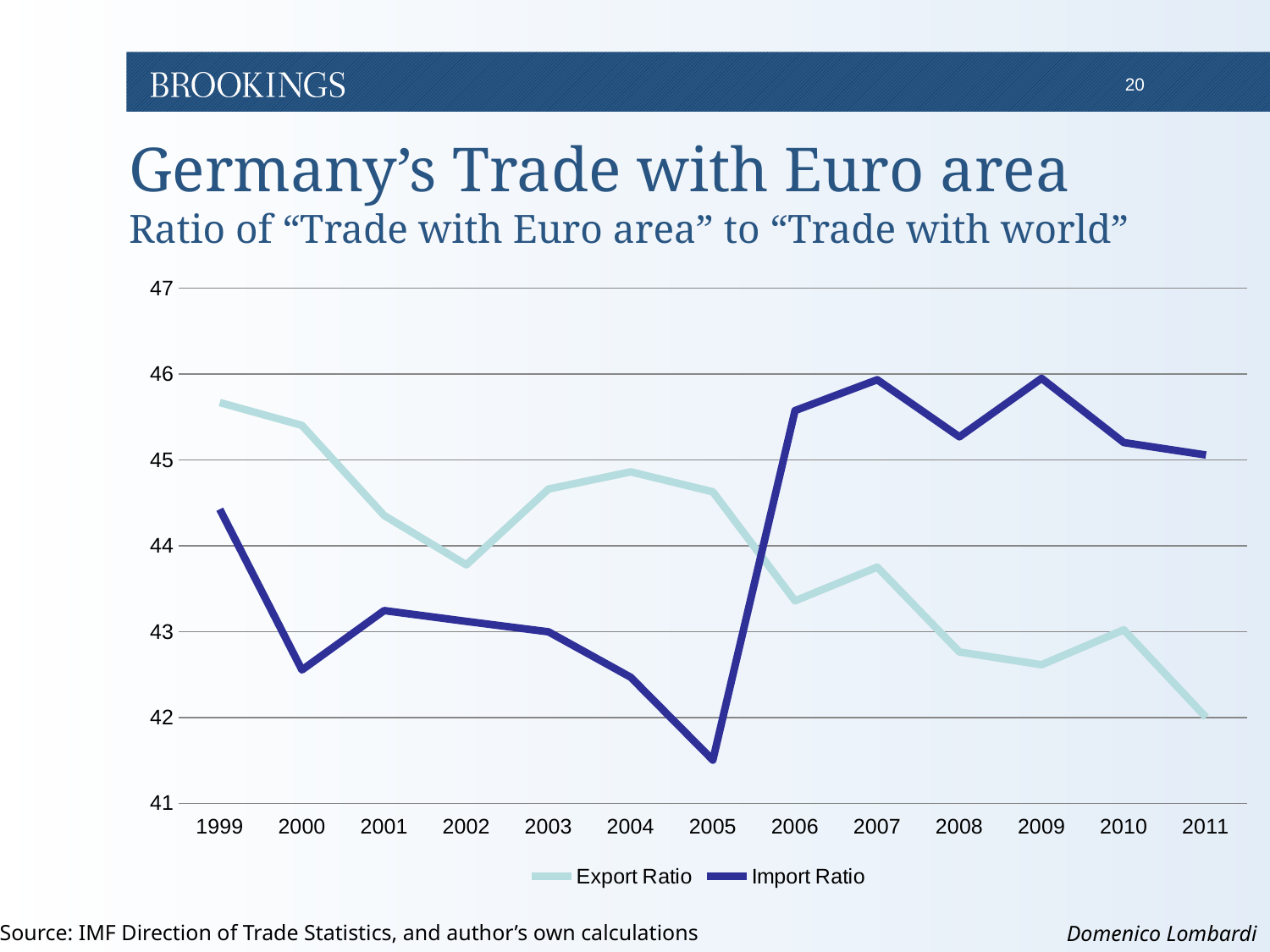
In which year is the Import Ratio lowest? 2005 Is the Export Ratio for 1999 greater or less than 45? greater In 2008, which is larger, the Export Ratio or the Import Ratio? Import Ratio Is the Import Ratio for 2006 greater or less than 45? greater How many series does the legend list? 2 Is the Import Ratio for 2005 greater or less than 42? less In which year is the Export Ratio lowest? 2011 In which year is the Export Ratio highest? 1999 Does the Export Ratio overall rise or fall from 1999 to 2011? fall How many years are plotted along the x axis? 13 In 2005, which is larger, the Export Ratio or the Import Ratio? Export Ratio What kind of chart is shown on the slide? line chart